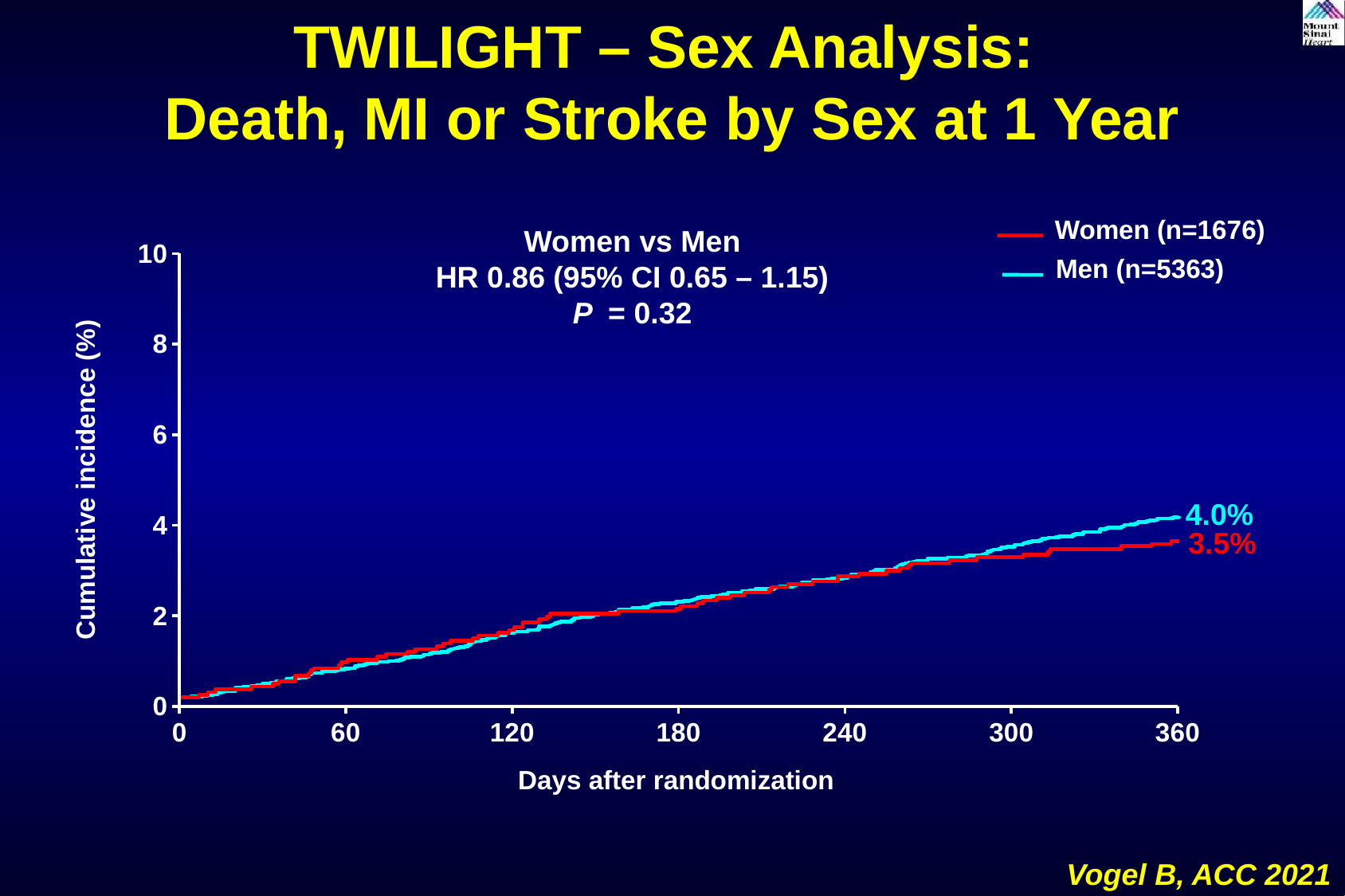
Is the cumulative incidence for Women at 360 days greater or less than 2? greater What is the cumulative incidence for Men at 360 days? 4.0% What is the difference between the Men and Women cumulative incidence values at 360 days? 0.5% How many series does the legend list? 2 Which group has the higher cumulative incidence at 360 days, Women or Men? Men What kind of chart is shown on the slide? Line chart Do the cumulative incidence curves rise or fall as days after randomization increase? Rise Is the cumulative incidence for Men at 360 days greater or less than 6? less What is the cumulative incidence for Women at 360 days? 3.5% What is the hazard ratio for Women vs Men shown on the chart? 0.86 What is the P value shown on the chart? 0.32 What is the label of the x axis? Days after randomization